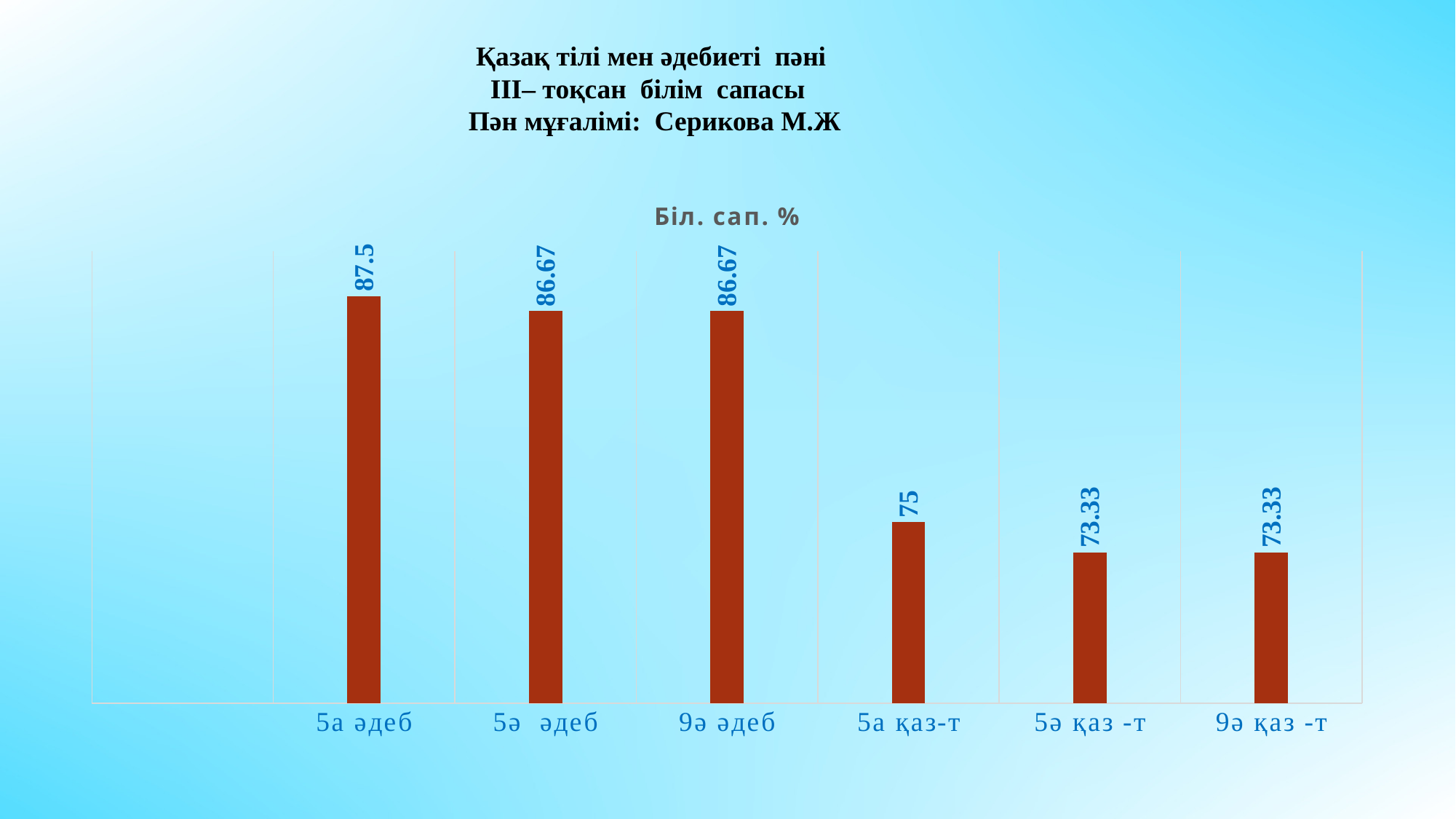
What is the value for 5а қаз-т? 75 Do the values rise or fall from left to right along the x axis? Fall What is the difference between the values for 5а қаз-т and 5ә қаз -т? 1.67 What is the lowest value shown in the chart? 73.33 What kind of chart is shown on the slide? Bar chart What is the difference between the values for 5а әдеб and 5а қаз-т? 12.5 What is the value for 9ә қаз -т? 73.33 What is the value for 5ә әдеб? 86.67 Which is larger, the value for 9ә әдеб or the value for 9ә қаз -т? 9ә әдеб What is the value for 5а әдеб? 87.5 How many categories are shown on the x axis? 6 Which category has the highest value? 5а әдеб